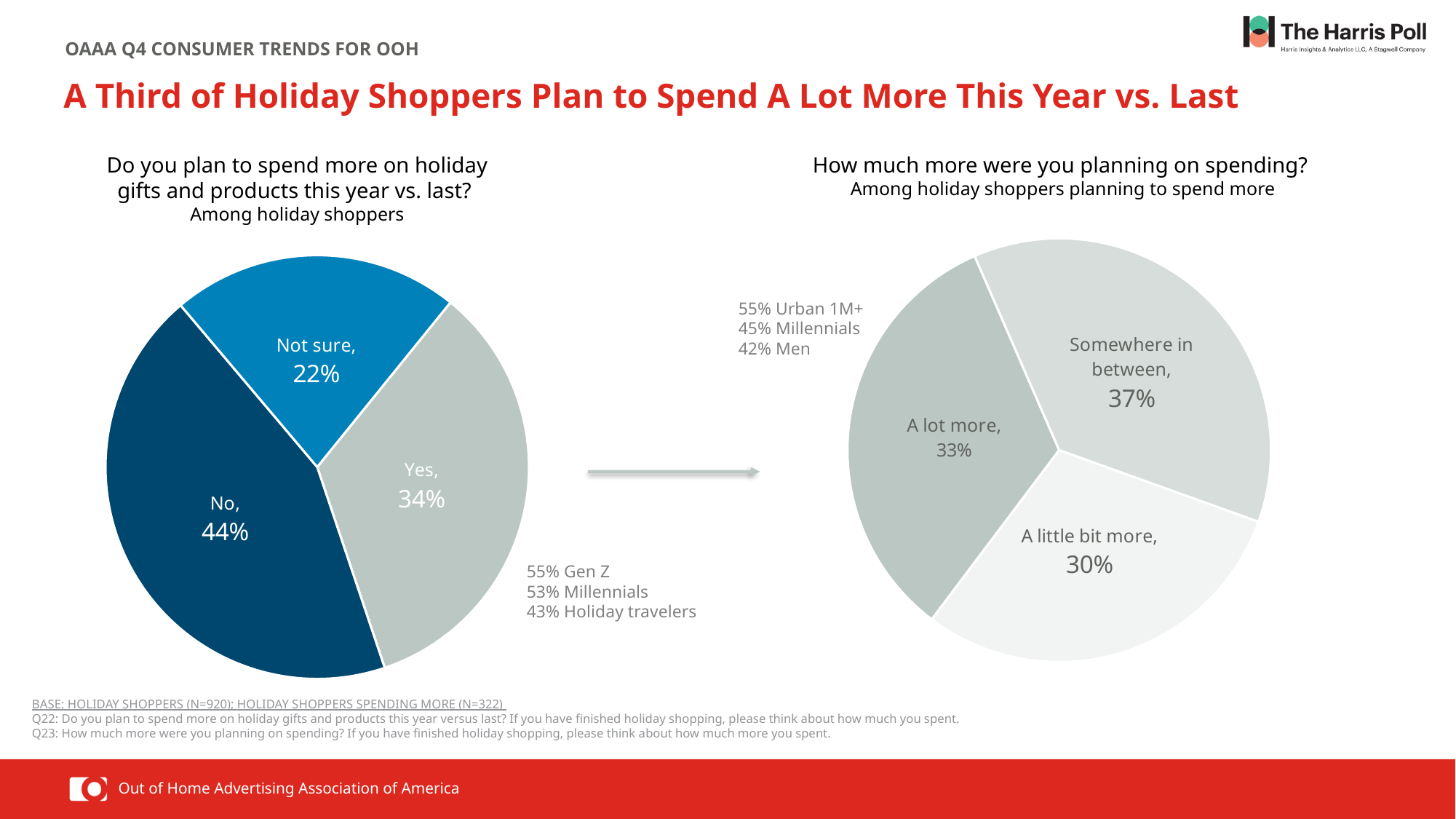
In the left pie chart, what share of holiday shoppers answered "Not sure"? 22% In the right pie chart, what share said "A little bit more"? 30% In the left pie chart, what share of holiday shoppers answered "Yes"? 34% How many slices does the right pie chart have? 3 In the right pie chart, which response has the largest share? Somewhere in between In the left pie chart, what is the difference in percentage points between "No" and "Yes"? 10 percentage points In the right pie chart, what share said "Somewhere in between"? 37% In the left pie chart, which response has the smallest share? Not sure In the left pie chart (Do you plan to spend more on holiday gifts and products this year vs. last?), what share of holiday shoppers answered "No"? 44% What type of chart is used on the left side of the slide? Pie chart In the right pie chart (How much more were you planning on spending?), what share said "A lot more"? 33% In the left pie chart, which response has the largest share? No